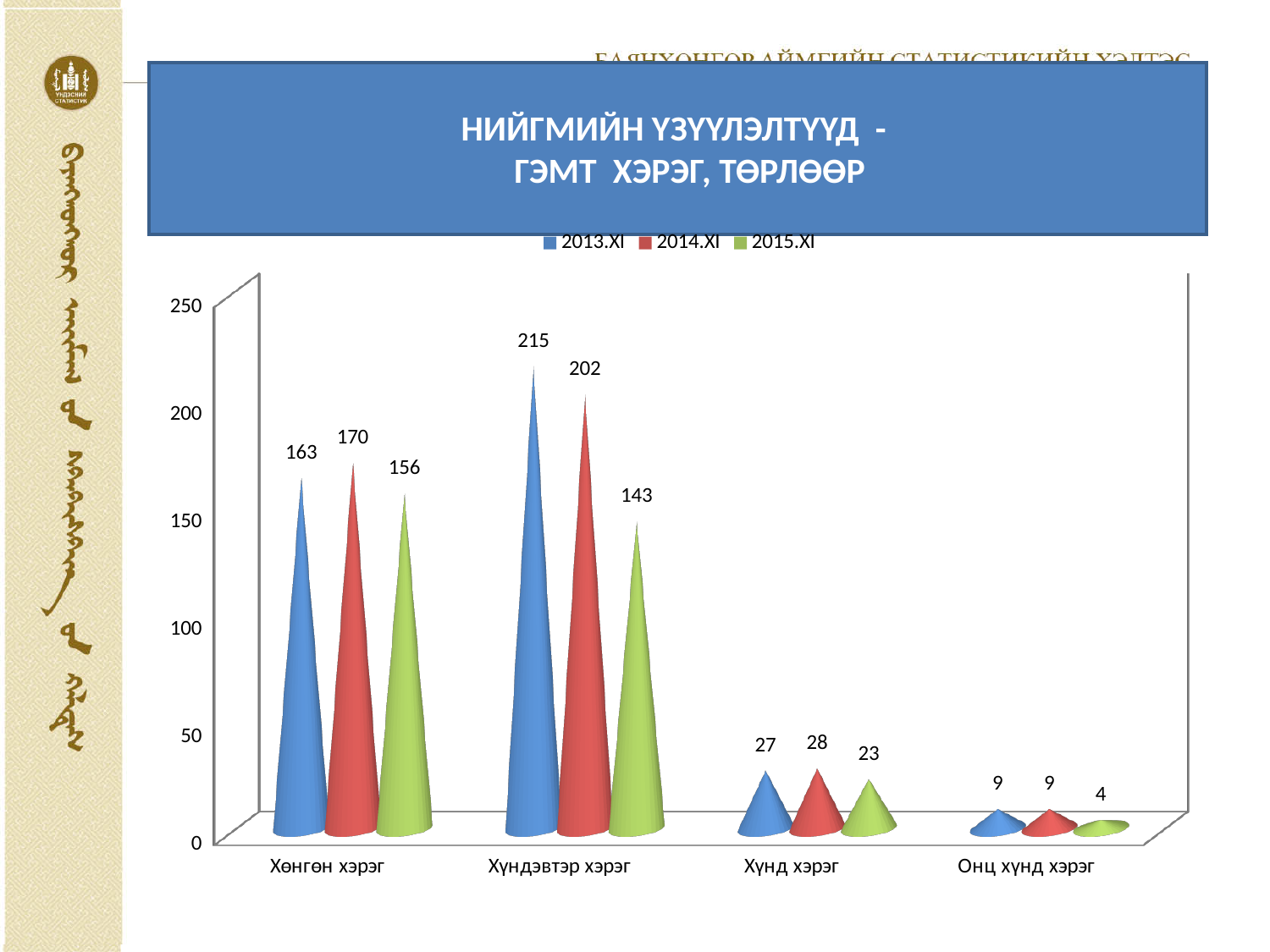
What is the value for Онц хүнд хэрэг in the 2015.XI series? 4 What kind of chart is shown on the slide? bar chart Which series is shown in green in the legend? 2015.XI Which category has the lowest value in the 2013.XI series? Онц хүнд хэрэг How many categories are shown on the x axis? 4 Is the 2015.XI value for Хүндэвтэр хэрэг greater or less than 150? less Which category has the highest value in the 2014.XI series? Хүндэвтэр хэрэг How many series does the legend list? 3 What is the difference between the 2013.XI and 2015.XI values for Хүндэвтэр хэрэг? 72 Which is larger for Хөнгөн хэрэг: the 2013.XI value or the 2014.XI value? 2014.XI What is the value for Хөнгөн хэрэг in the 2015.XI series? 156 What is the value for Хүндэвтэр хэрэг in the 2013.XI series? 215